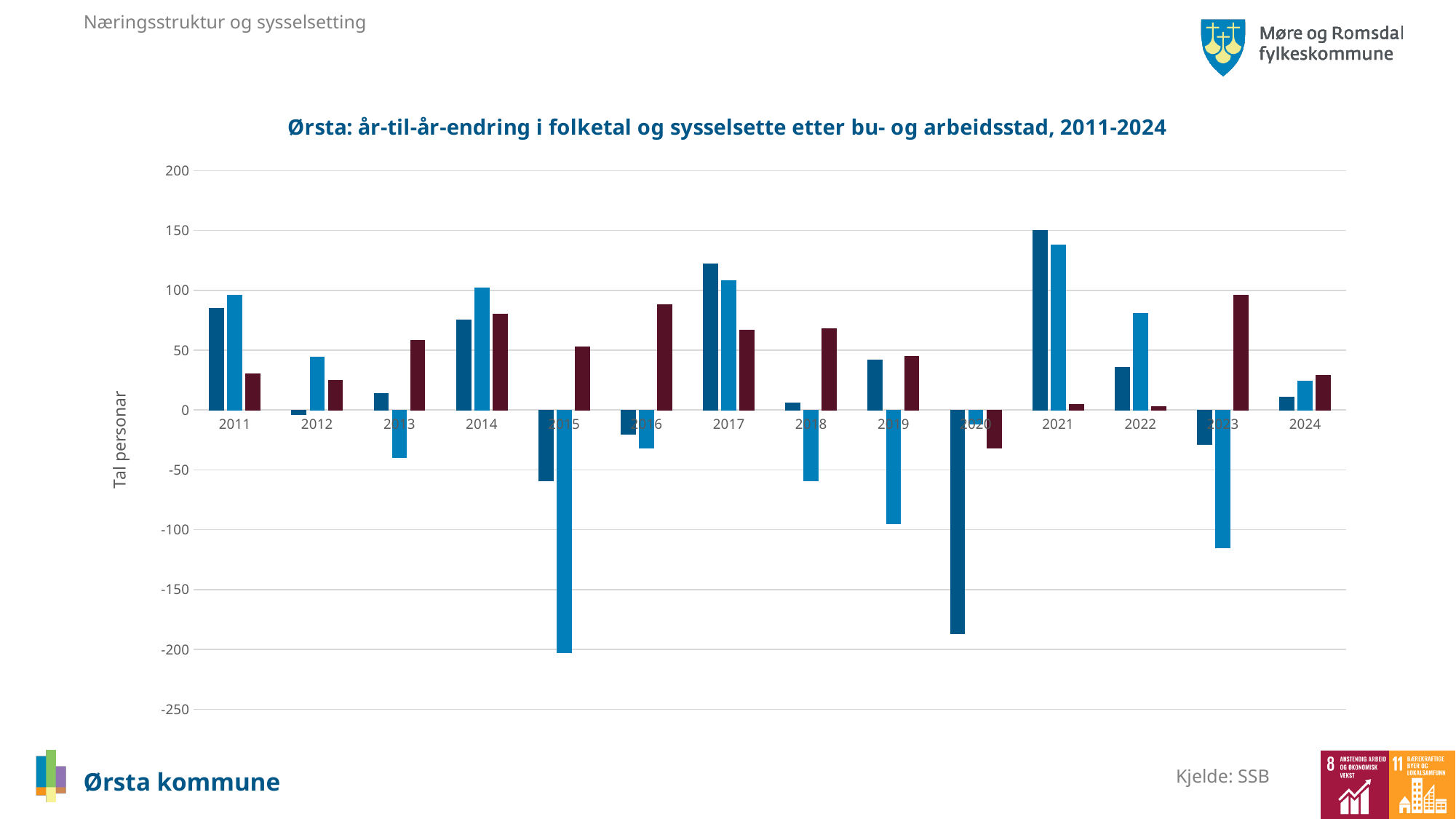
What kind of chart is shown on the slide? bar chart How many bars are plotted for each year in the chart? 3 How many years are shown along the x axis of the chart? 14 In which year is the dark blue bar at its highest value? 2021 In which year is the dark red bar at its lowest value? 2020 What is the label on the vertical axis of the chart? Tal personar Is the value of the dark blue bar for 2021 greater or less than 100? greater In which year is the dark blue bar at its lowest value? 2020 Is the value of the light blue bar for 2015 greater or less than -150? less In which year is the light blue bar at its lowest value? 2015 What is the title of the chart? Ørsta: år-til-år-endring i folketal og sysselsette etter bu- og arbeidsstad, 2011-2024 Which is larger: the dark blue bar for 2021 or the dark blue bar for 2017? 2021